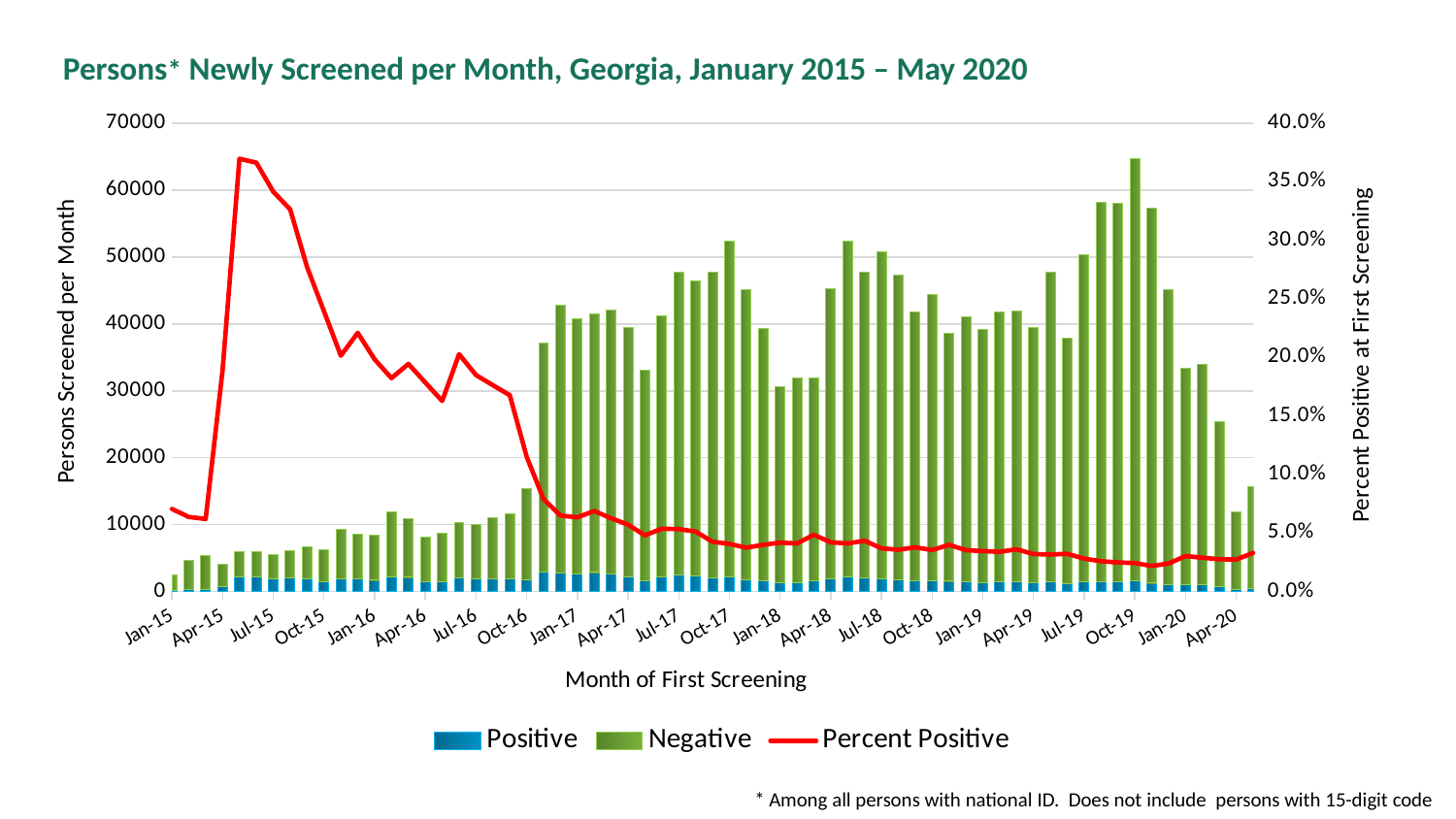
In which month is the total number of persons newly screened the lowest? Jan-15 Is the Percent Positive value for Jan-18 greater or less than 10.0%? less Is the total number of persons screened in Oct-19 greater or less than 60000? greater In which month is the total number of persons newly screened the highest? Oct-19 What kind of chart is shown on the slide? A combination bar and line chart Which is larger, the Percent Positive value for Jul-15 or for Jul-19? Jul-15 Does the Percent Positive line generally rise or fall from Jan-17 to Apr-20? fall Is the Percent Positive value for Jul-15 greater or less than 30.0%? greater What is the title of the chart? Persons* Newly Screened per Month, Georgia, January 2015 – May 2020 Which series is plotted as a red line? Percent Positive How many series does the legend list? 3